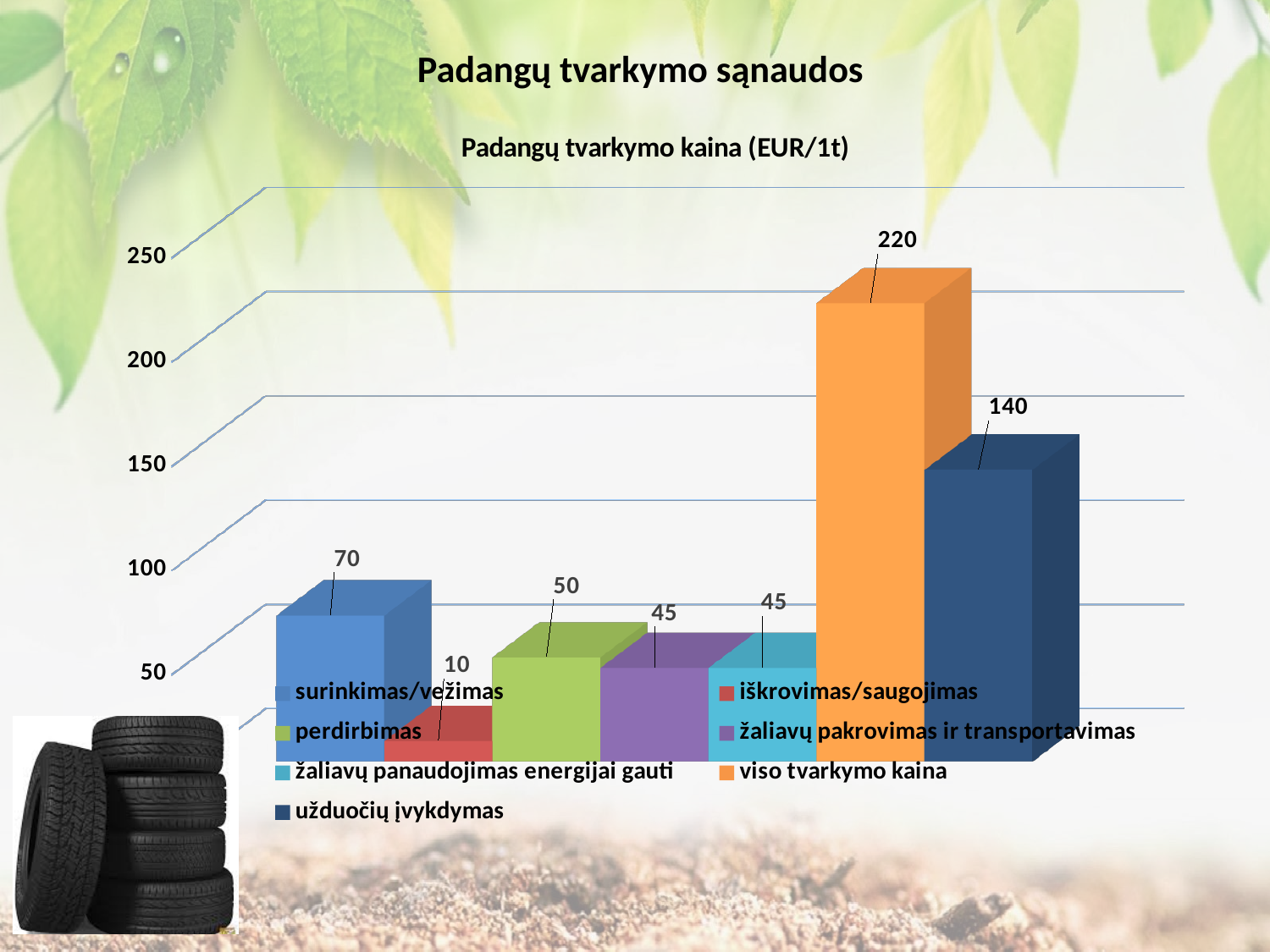
What is the value for surinkimas/vežimas? 70 What type of chart is shown on the slide? bar chart Which series has the highest value? viso tvarkymo kaina What is the value for iškrovimas/saugojimas? 10 What is the value for perdirbimas? 50 Which series has the lowest value? iškrovimas/saugojimas What is the title of the chart? Padangų tvarkymo kaina (EUR/1t) How many series does the legend list? 7 What is the value for viso tvarkymo kaina? 220 What is the value for užduočių įvykdymas? 140 What is the difference between viso tvarkymo kaina and užduočių įvykdymas? 80 Which is larger, surinkimas/vežimas or perdirbimas? surinkimas/vežimas